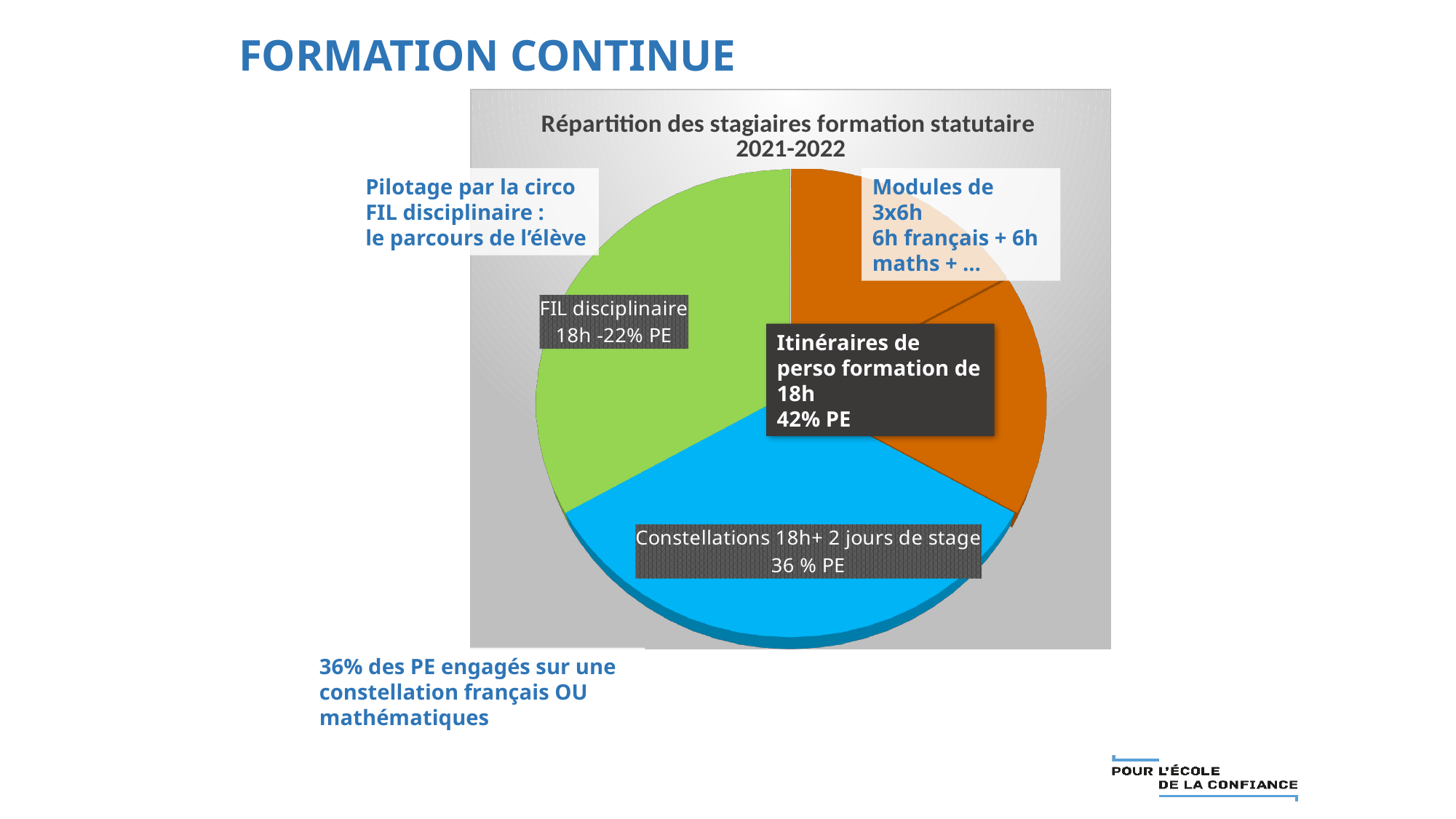
What type of chart is shown on the slide? Pie chart How many slices does the pie chart have? 4 What percentage of PE is shown for the Constellations 18h + 2 jours de stage slice? 36 % PE What is the title of the chart? Répartition des stagiaires formation statutaire 2021-2022 What percentage of PE is shown for the Itinéraires de perso formation de 18h slice? 42% PE What percentage of PE is shown for the FIL disciplinaire slice? 22% PE What is the difference in percentage points between the Constellations slice and the FIL disciplinaire slice? 14 What is the difference in percentage points between the Itinéraires de perso formation slice and the FIL disciplinaire slice? 20 What colour is the Constellations 18h + 2 jours de stage slice? Blue